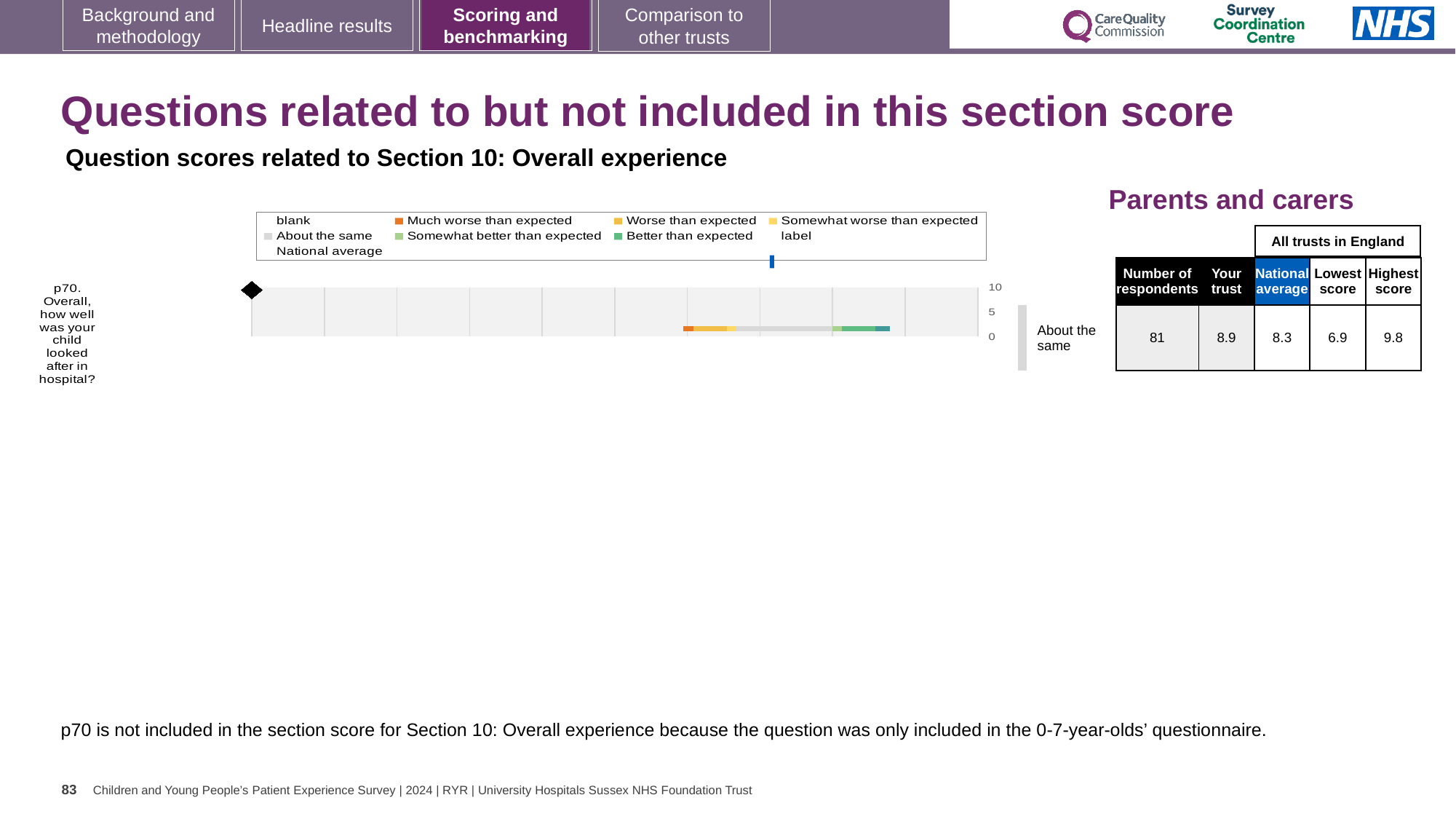
What is the highest score among all trusts in England for p70? 9.8 How many respondents answered p70? 81 How many questions are plotted in the chart? 1 Which is larger for p70, the 'Your trust' score or the national average? Your trust What is the difference between the highest and lowest trust scores for p70? 2.9 What is the national average score for p70 in the accompanying table? 8.3 What is the lowest score among all trusts in England for p70? 6.9 What category label is shown beside the chart for p70? About the same Which respondent group does the chart and table refer to? Parents and carers What kind of chart is used to show the p70 question score? Bar chart What is the 'Your trust' score for p70 in the accompanying table? 8.9 What is the highest value shown on the chart's axis? 10